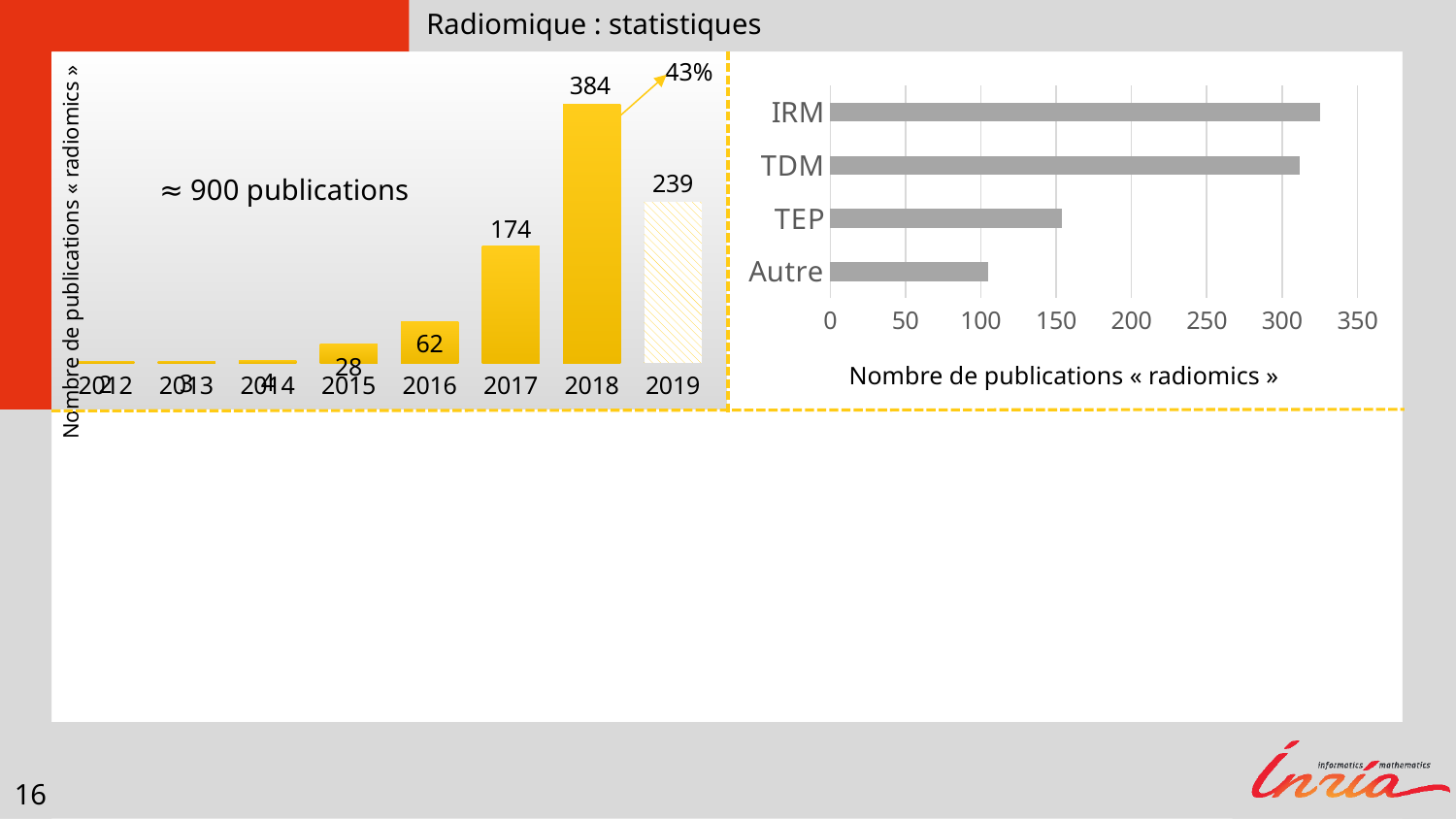
In the left chart, what is the difference between the values for 2018 and 2017? 210 In the right chart titled 'Nombre de publications « radiomics »', is the value for TEP greater or less than 200? less In the left chart, what is the value for 2017? 174 In the right chart titled 'Nombre de publications « radiomics »', is the value for IRM greater or less than 300? greater What kind of chart is the right chart titled 'Nombre de publications « radiomics »'? bar chart In the left chart, which year has the highest number of publications? 2018 In the left chart, how many publications are shown for 2018? 384 In the left chart, which is larger, the value for 2019 or the value for 2017? 2019 In the right chart titled 'Nombre de publications « radiomics »', which category has the lowest value? Autre In the left chart, what is the value for 2016? 62 In the left chart, what is the value for 2019? 239 In the left chart, how many years are shown on the x axis? 8